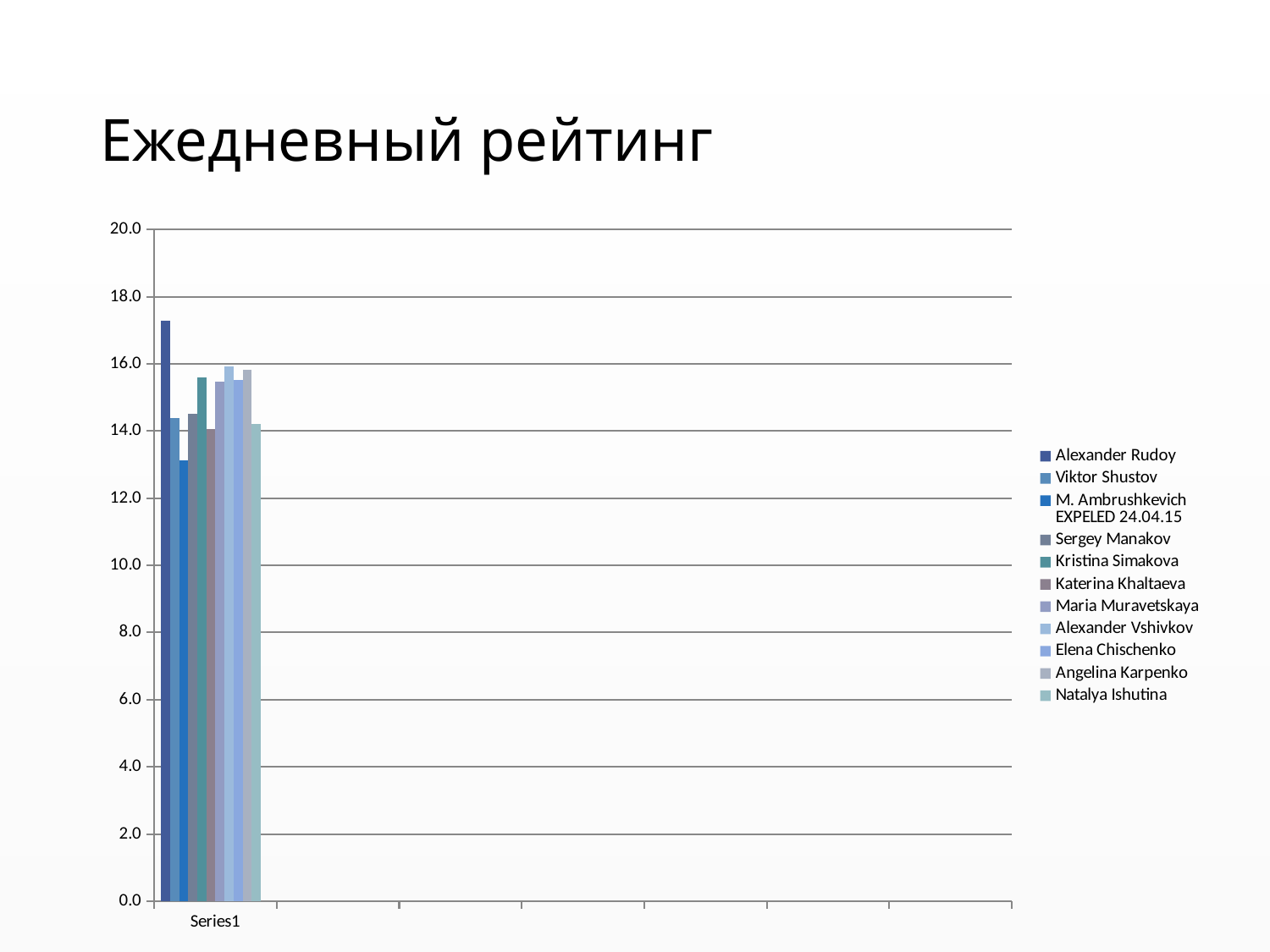
Which is larger, the value for Kristina Simakova or the value for Katerina Khaltaeva? Kristina Simakova Is the value for Natalya Ishutina greater or less than 16.0? less How many categories are shown on the x axis? 1 What kind of chart is shown on the slide? bar chart What is the title of the slide? Ежедневный рейтинг Is the value for M. Ambrushkevich EXPELED 24.04.15 greater or less than 14.0? less Is the value for Kristina Simakova greater or less than 14.0? greater Which series has the highest bar? Alexander Rudoy Which is larger, the value for Alexander Rudoy or the value for Viktor Shustov? Alexander Rudoy How many series does the legend list? 11 Which series has the lowest bar? M. Ambrushkevich EXPELED 24.04.15